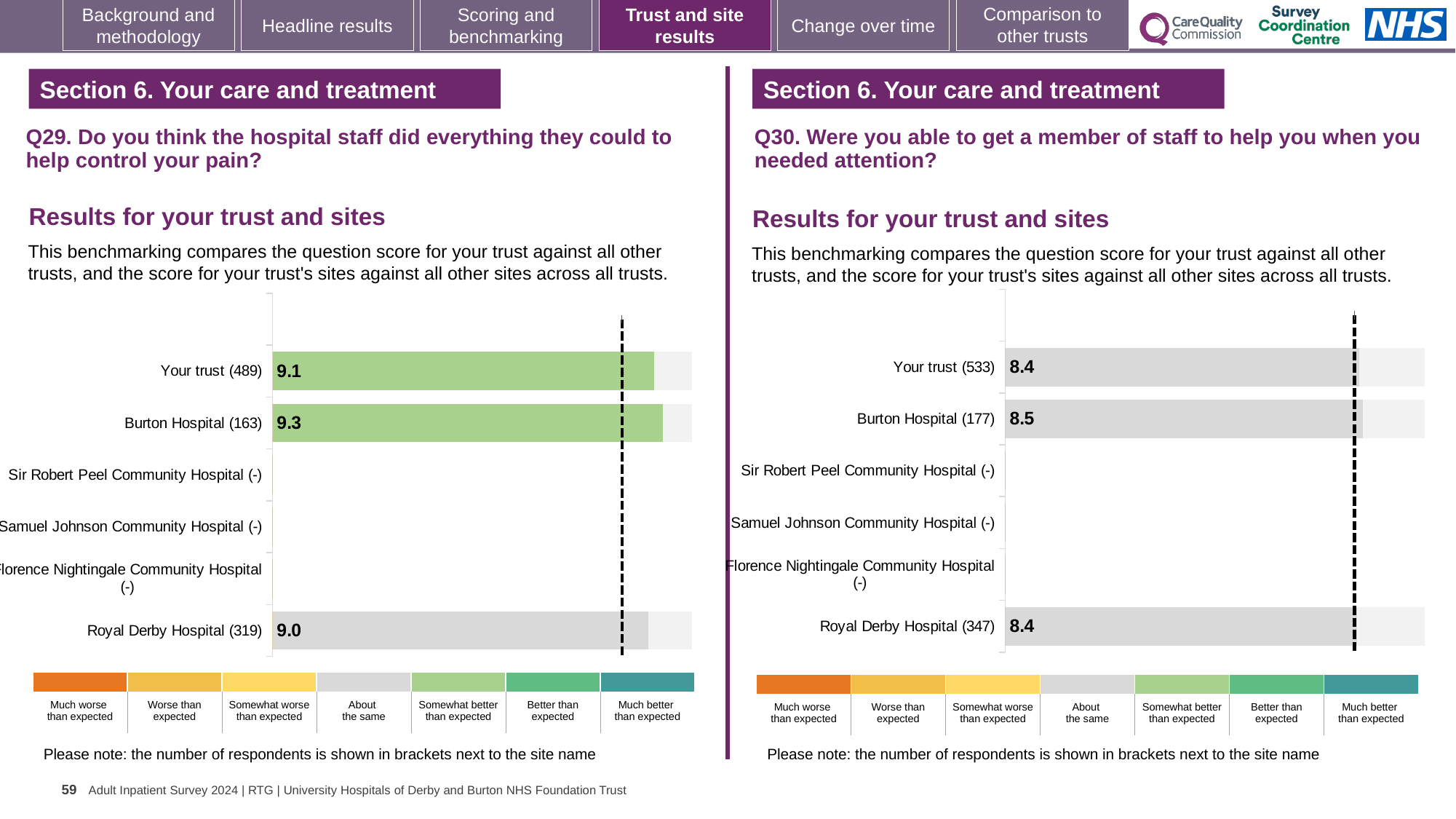
How many sites or trusts are listed on the vertical axis of the Q29 chart? 6 In the Q29 chart, what is the score for Your trust (489)? 9.1 In the Q29 chart, which site or trust has the highest score? Burton Hospital (163) In the Q30 chart, which is larger, the score for Burton Hospital or the score for Your trust? Burton Hospital In the Q30 chart, what is the score for Burton Hospital (177)? 8.5 In the Q29 chart, what is the score for Royal Derby Hospital (319)? 9.0 In the Q29 chart, what is the difference between the scores for Burton Hospital and Royal Derby Hospital? 0.3 In the Q30 chart, what is the difference between the scores for Burton Hospital and Your trust? 0.1 What kind of chart is used for the Q30 results? Bar chart In the Q29 chart, what is the score for Burton Hospital (163)? 9.3 In the Q30 chart, what is the score for Royal Derby Hospital (347)? 8.4 In the Q29 chart, which site or trust has the lowest score? Royal Derby Hospital (319)